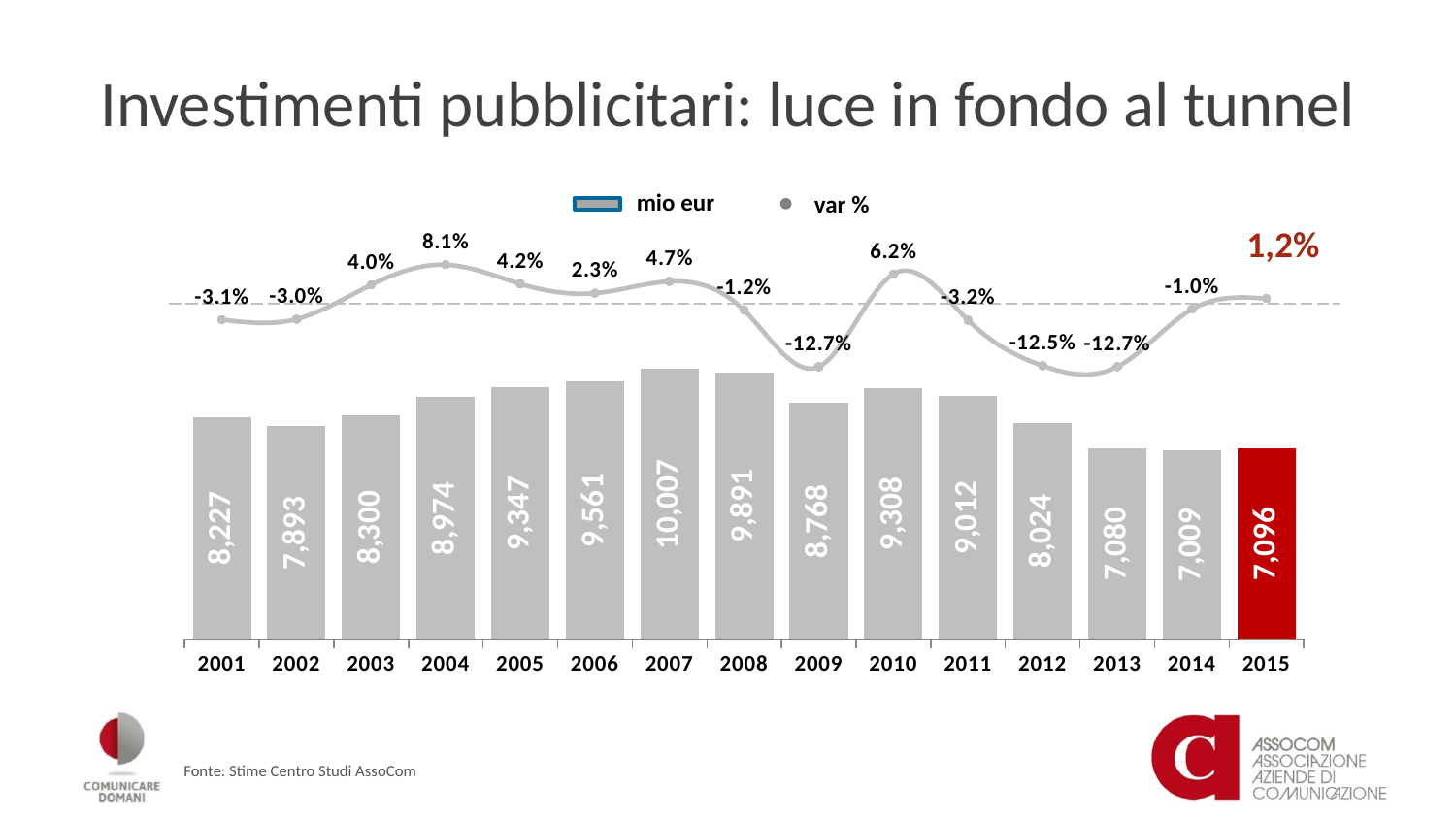
What is the difference in mio eur between 2007 and 2008? 116 How many years are shown on the x axis? 15 Which is larger, the mio eur value for 2010 or for 2011? 2010 What is the mio eur value for 2015? 7,096 What kind of chart is shown on the slide? Combined bar and line chart Which year has the highest mio eur value? 2007 Which bar is coloured red instead of grey? 2015 Which year has the lowest mio eur value? 2014 Which year has the highest var % value? 2004 What is the mio eur value for 2007? 10,007 What is the var % value for 2009? -12.7% How many series does the legend list? 2